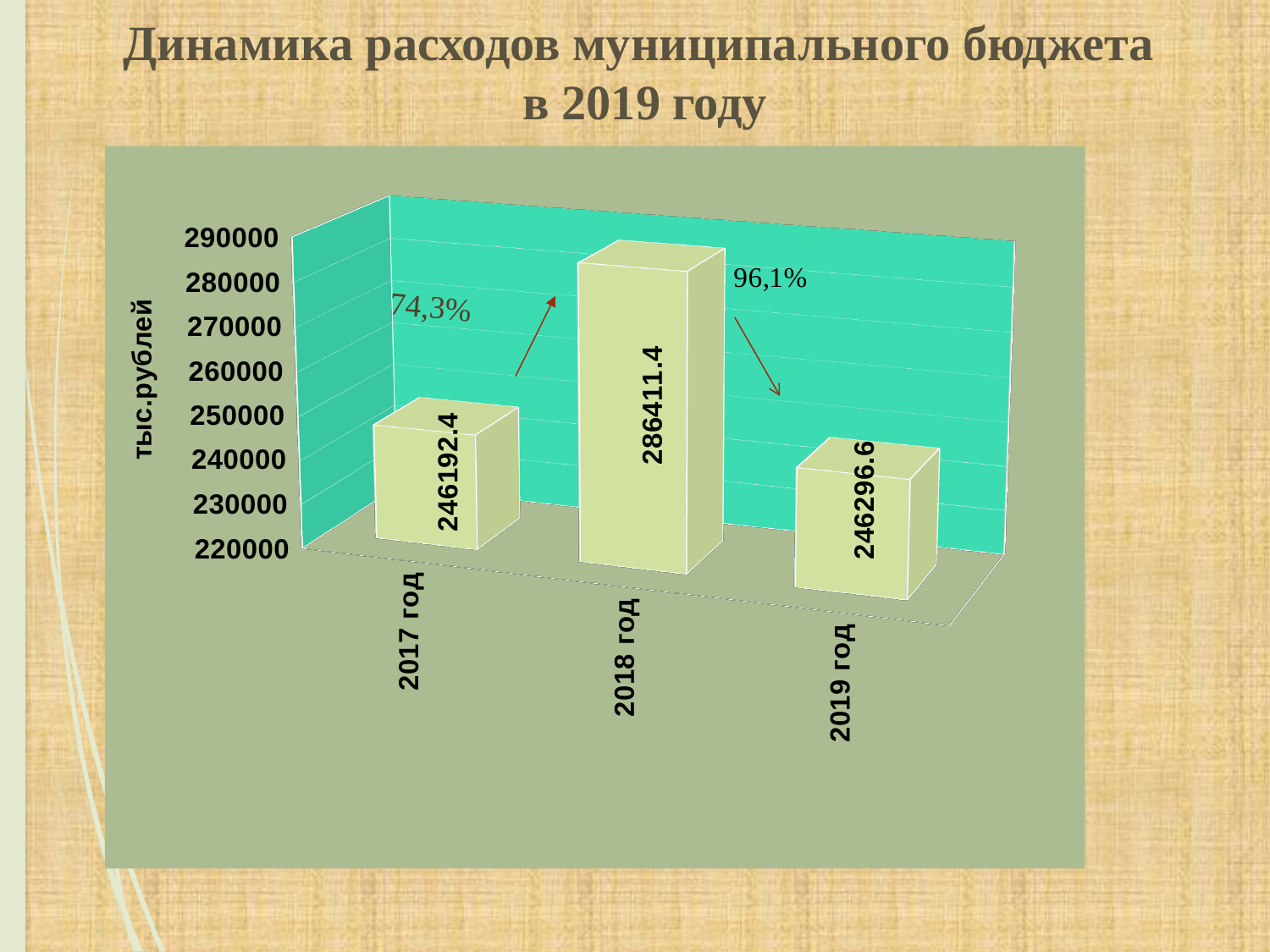
What is the value for 2018 год? 286411.4 What is the difference between the values for 2018 год and 2017 год? 40219.0 Which is larger, the value for 2018 год or the value for 2019 год? 2018 год What is the label of the vertical axis? тыс.рублей What kind of chart is shown on the slide? bar chart What is the value for 2019 год? 246296.6 Which year has the highest value? 2018 год Is the value for 2017 год greater or less than 250000? less What is the difference between the values for 2018 год and 2019 год? 40114.8 Is the value for 2018 год greater or less than 280000? greater What is the value for 2017 год? 246192.4 How many years are shown on the chart? 3